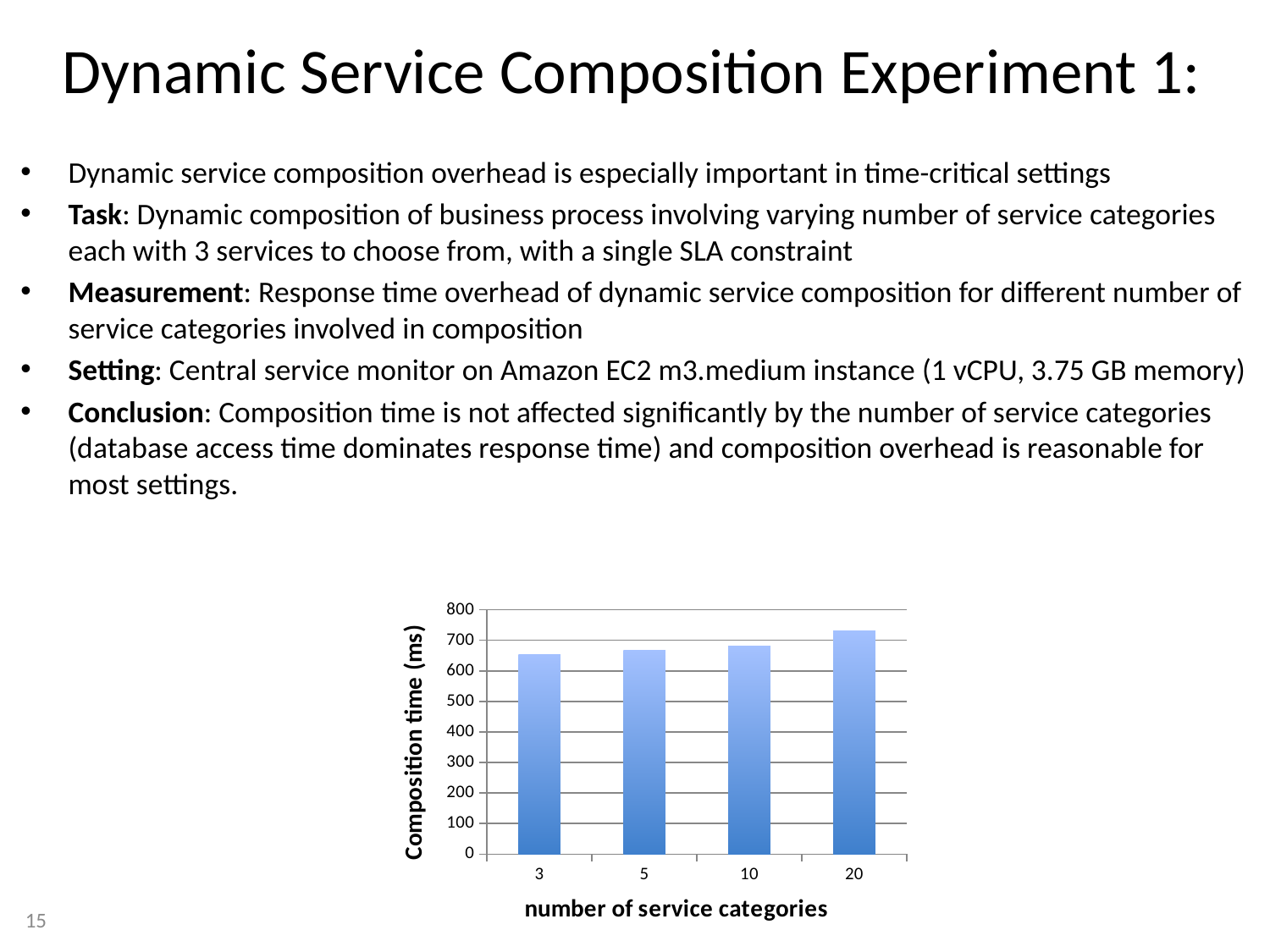
Which has a larger composition time: 10 service categories or 20 service categories? 20 How many categories (numbers of service categories) are plotted on the x axis? 4 Which number of service categories has the highest composition time? 20 Is the composition time for 10 service categories greater or less than 700? less Do the composition times rise or fall as the number of service categories increases along the x axis? rise What is the label of the x axis of the chart? number of service categories Which has a larger composition time: 20 service categories or 3 service categories? 20 Is the composition time for 3 service categories greater or less than 700? less What kind of chart is shown on the slide? bar chart Is the composition time for 20 service categories greater or less than 700? greater What is the label of the y axis of the chart? Composition time (ms)